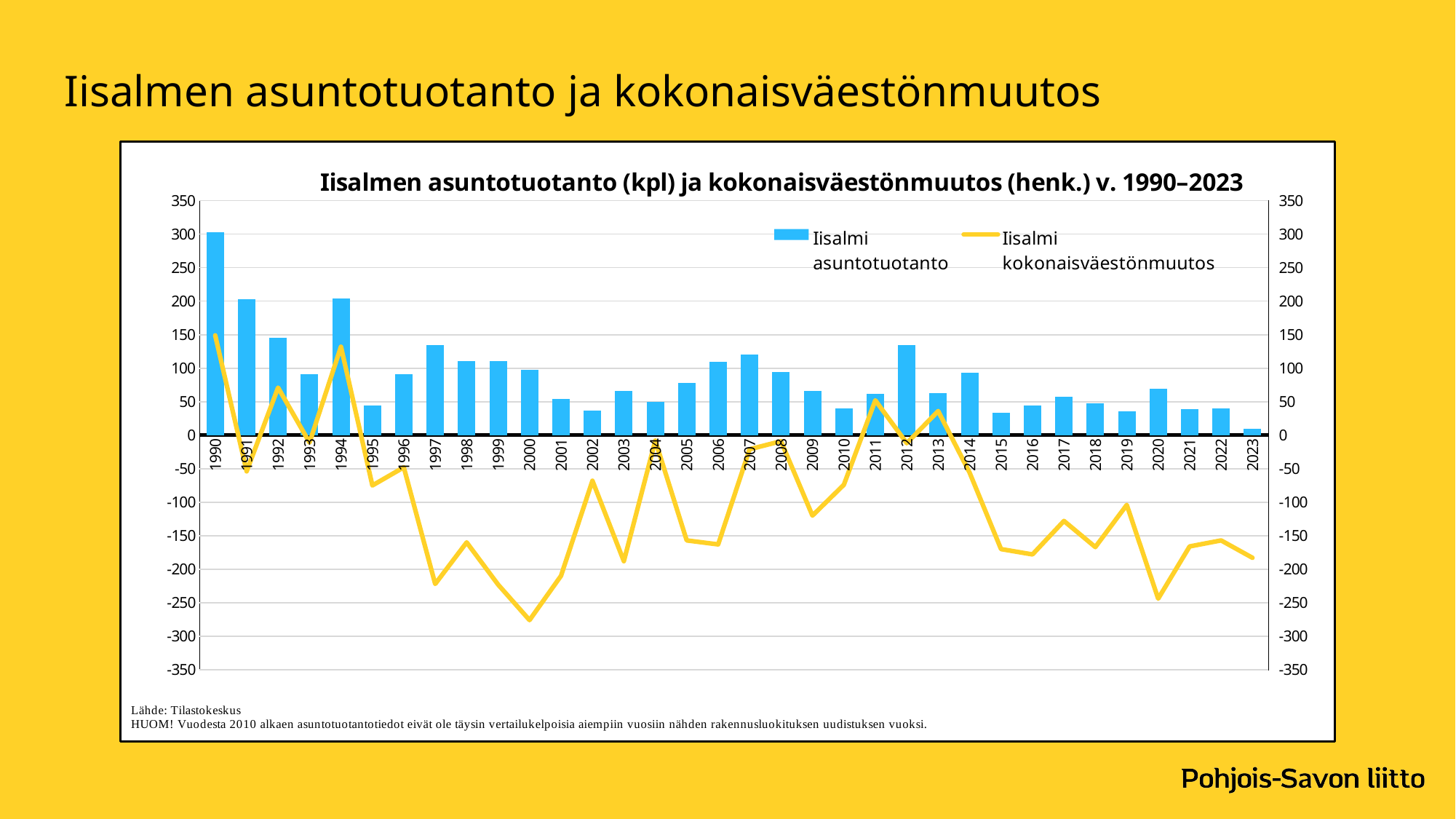
Is the Iisalmi asuntotuotanto value for 2012 greater or less than 100? greater In which year does the Iisalmi kokonaisväestönmuutos line reach its highest point? 1990 Which year has the highest bar for Iisalmi asuntotuotanto? 1990 In which year does the Iisalmi kokonaisväestönmuutos line reach its lowest point? 2000 How many series does the legend list? 2 Is the Iisalmi asuntotuotanto value for 1990 greater or less than 250? greater Which year has the lowest bar for Iisalmi asuntotuotanto? 2023 Do the Iisalmi asuntotuotanto bars generally rise or fall from 1990 to 2023? fall Which year has the larger Iisalmi asuntotuotanto bar, 2012 or 2014? 2012 How many years are shown on the x axis? 34 What kind of chart is shown on the slide? A combined bar and line chart Is the Iisalmi kokonaisväestönmuutos value for 2000 greater or less than -250? less